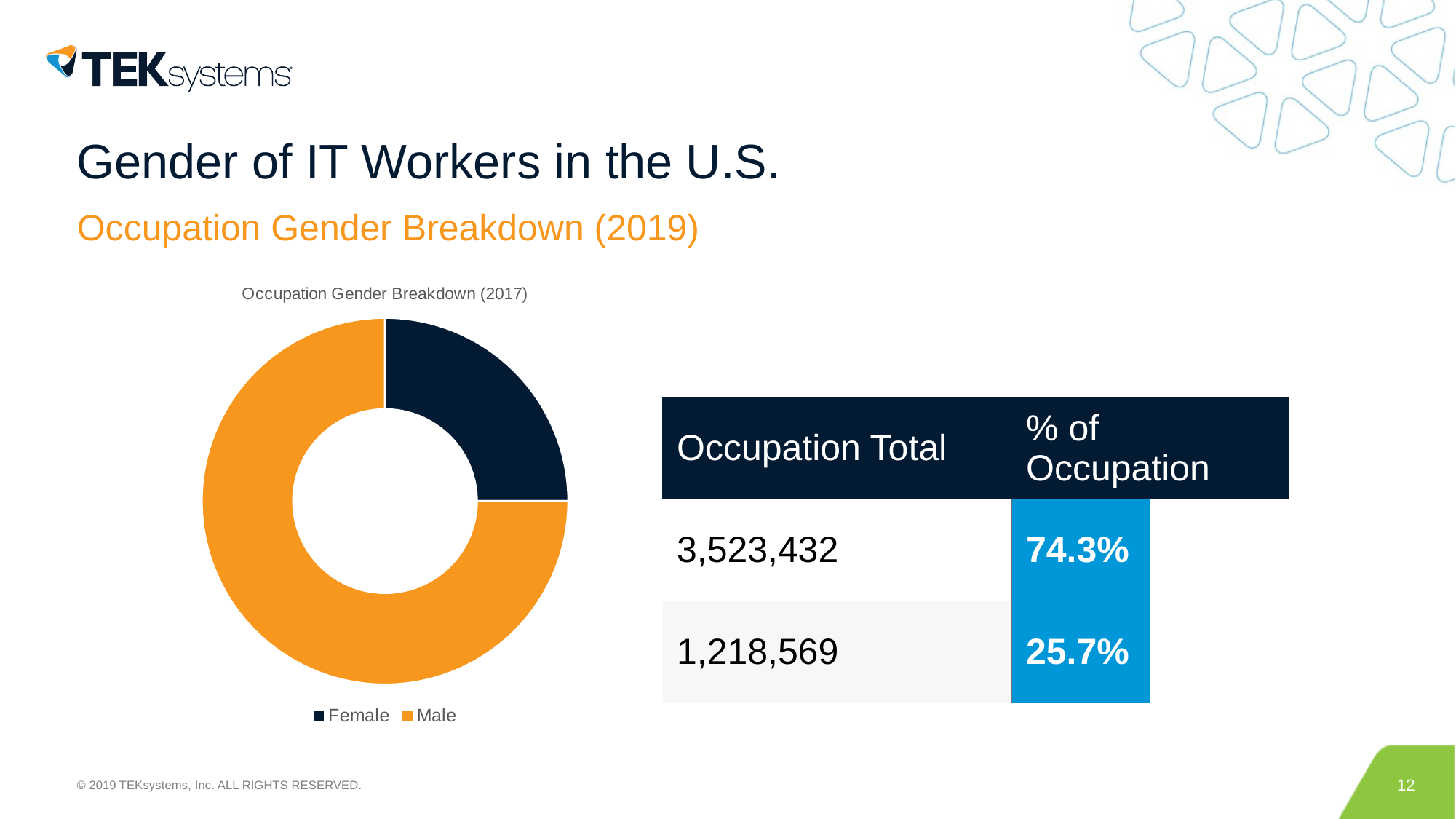
Does the Male slice make up more or less than half of the chart? more than half What colour is the Male slice in the chart? orange What kind of chart is shown on the slide? donut (pie) chart Which gender has the smallest slice in the chart? Female What is the title of the chart? Occupation Gender Breakdown (2017) How many categories does the legend of the chart list? 2 How many slices does the donut chart have? 2 Which slice is larger in the chart, Female or Male? Male Which gender has the largest slice in the chart? Male